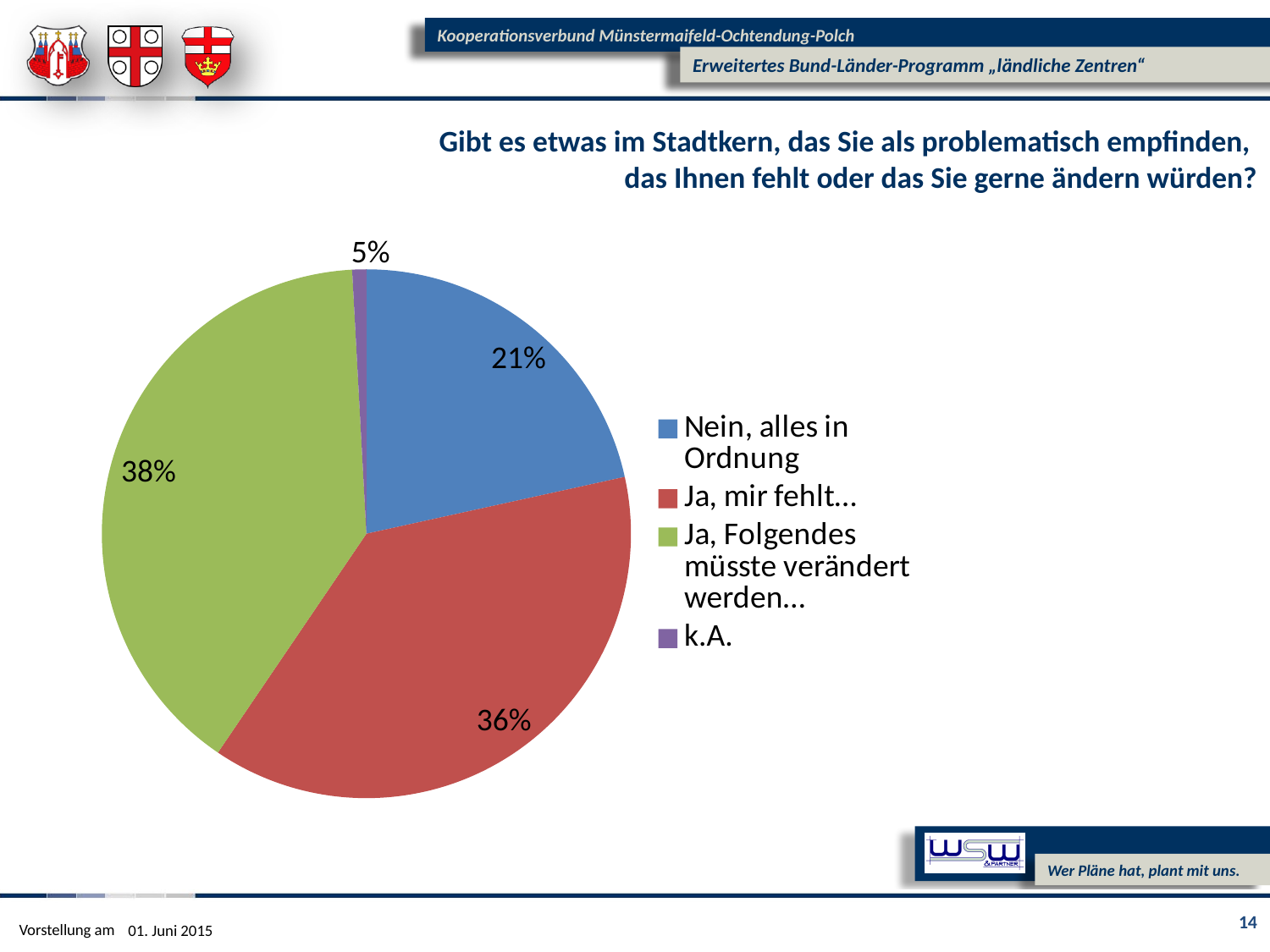
What is the difference in percentage points between "Ja, mir fehlt…" and "Nein, alles in Ordnung"? 15 What kind of chart is shown on the slide? pie chart Which is larger: the share for "Nein, alles in Ordnung" or the share for "Ja, mir fehlt…"? Ja, mir fehlt… Which category has the smallest slice of the pie? k.A. What is the difference in percentage points between the largest and smallest slices? 33 What share of the pie does "Ja, mir fehlt…" have? 36% Which category has the largest slice of the pie? Ja, Folgendes müsste verändert werden… What share of the pie does "k.A." have? 5% What share of the pie does "Nein, alles in Ordnung" have? 21% How many categories does the pie chart have? 4 What colour is the slice for "k.A."? purple